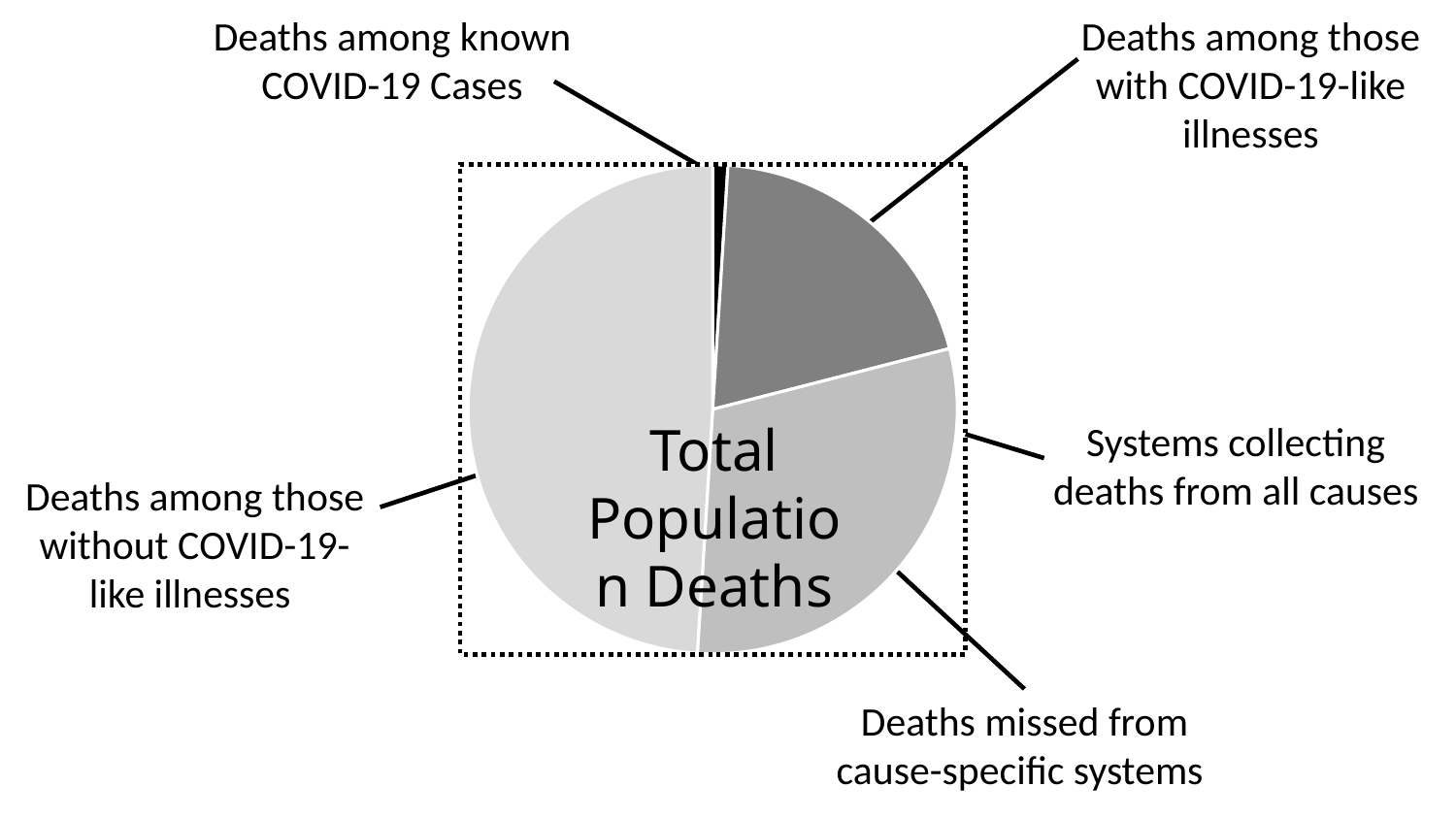
What does the dotted box around the pie chart represent, according to its label? Systems collecting deaths from all causes Which slice is larger: 'Deaths missed from cause-specific systems' or 'Deaths among those with COVID-19-like illnesses'? Deaths missed from cause-specific systems What text is written in the centre of the pie chart? Total Population Deaths How many slices does the pie chart have? 4 Which slice is larger: 'Deaths among those without COVID-19-like illnesses' or 'Deaths among those with COVID-19-like illnesses'? Deaths among those without COVID-19-like illnesses What kind of chart is shown on the slide? Pie chart Which slice is larger: 'Deaths missed from cause-specific systems' or 'Deaths among known COVID-19 Cases'? Deaths missed from cause-specific systems Which slice of the pie chart is the smallest? Deaths among known COVID-19 Cases Which slice of the pie chart is the largest? Deaths among those without COVID-19-like illnesses